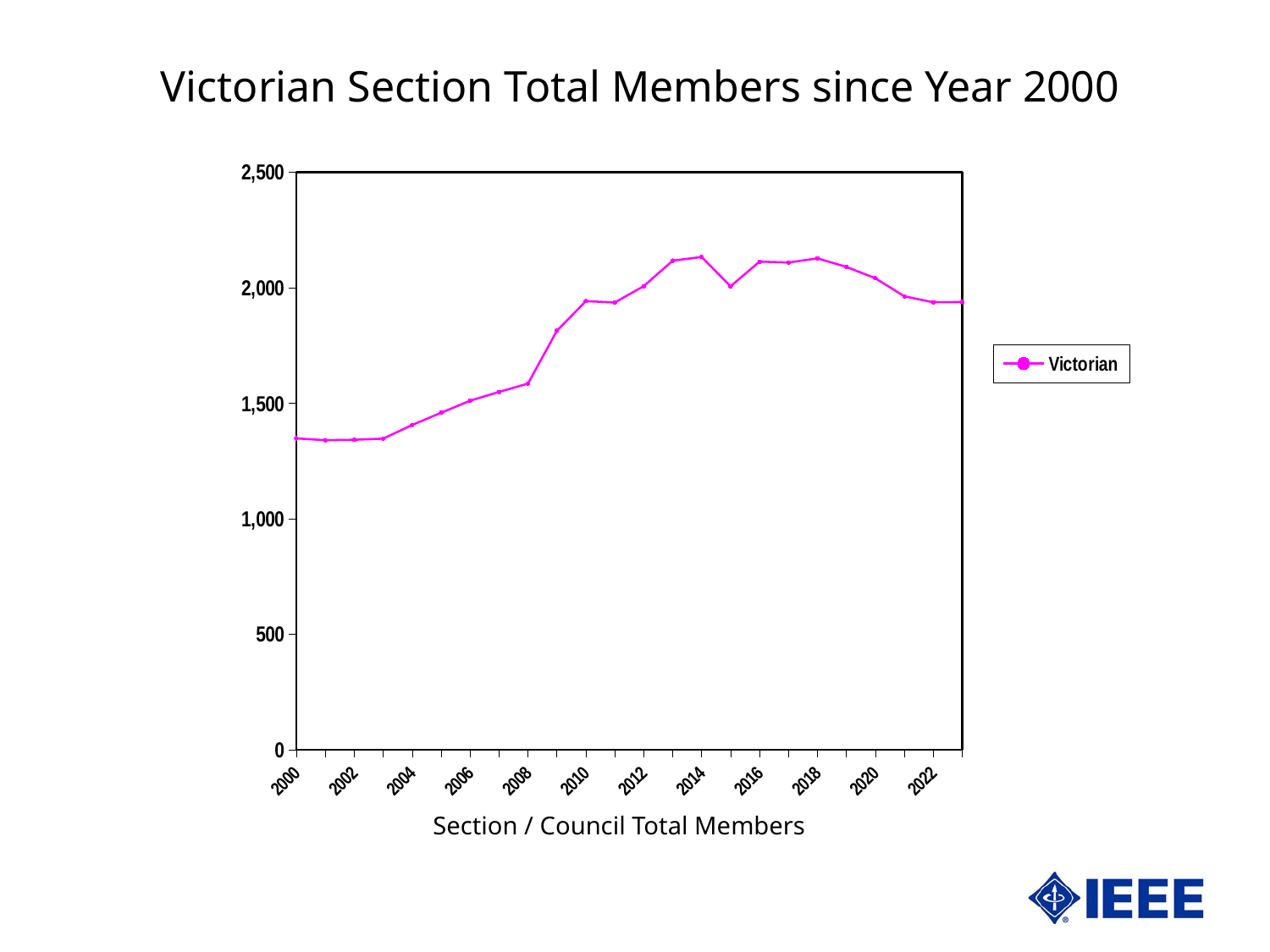
Is the value for 2000 greater or less than 1,500? less How many series does the legend list? 1 Which year has the larger value, 2000 or 2014? 2014 What kind of chart is shown on the slide? line chart What is the title of the chart? Victorian Section Total Members since Year 2000 Which year has the larger value, 2004 or 2010? 2010 Is the value for 2022 greater or less than 2,000? less Is the value for 2008 greater or less than 1,500? greater What is the name of the series shown in the legend? Victorian Do the values generally rise or fall between 2000 and 2014? rise